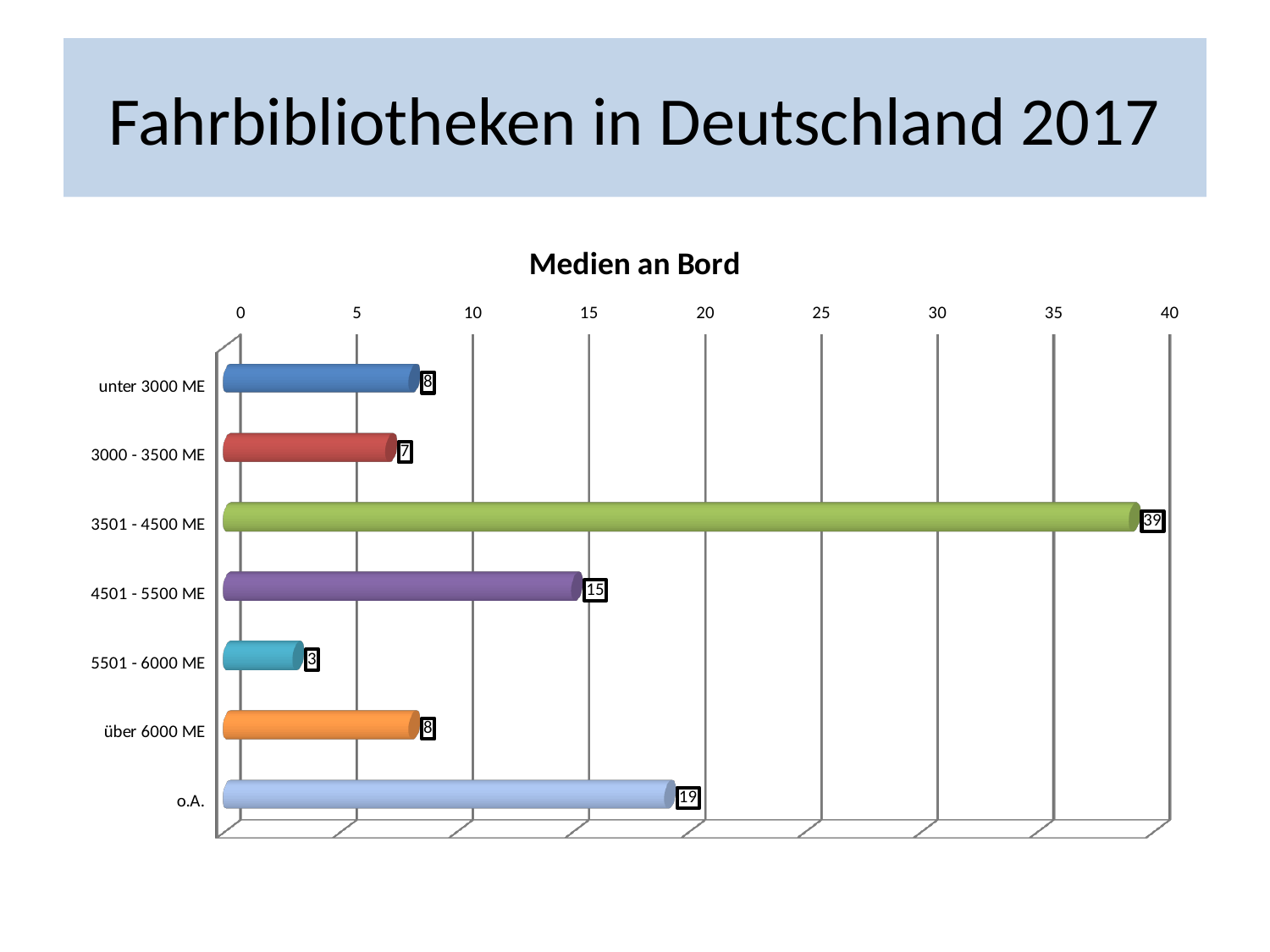
What is the value for 5501 - 6000 ME? 3 What is the difference between the values for 4501 - 5500 ME and 3000 - 3500 ME? 8 What is the title of the chart? Medien an Bord What is the value for 4501 - 5500 ME? 15 Which category has the highest value? 3501 - 4500 ME What is the value for 3501 - 4500 ME? 39 What is the value for o.A.? 19 Which category has the lowest value? 5501 - 6000 ME What kind of chart is shown on the slide? bar chart Which is larger, the value for o.A. or the value for 4501 - 5500 ME? o.A. What is the difference between the values for 3501 - 4500 ME and o.A.? 20 How many categories are shown in the chart? 7